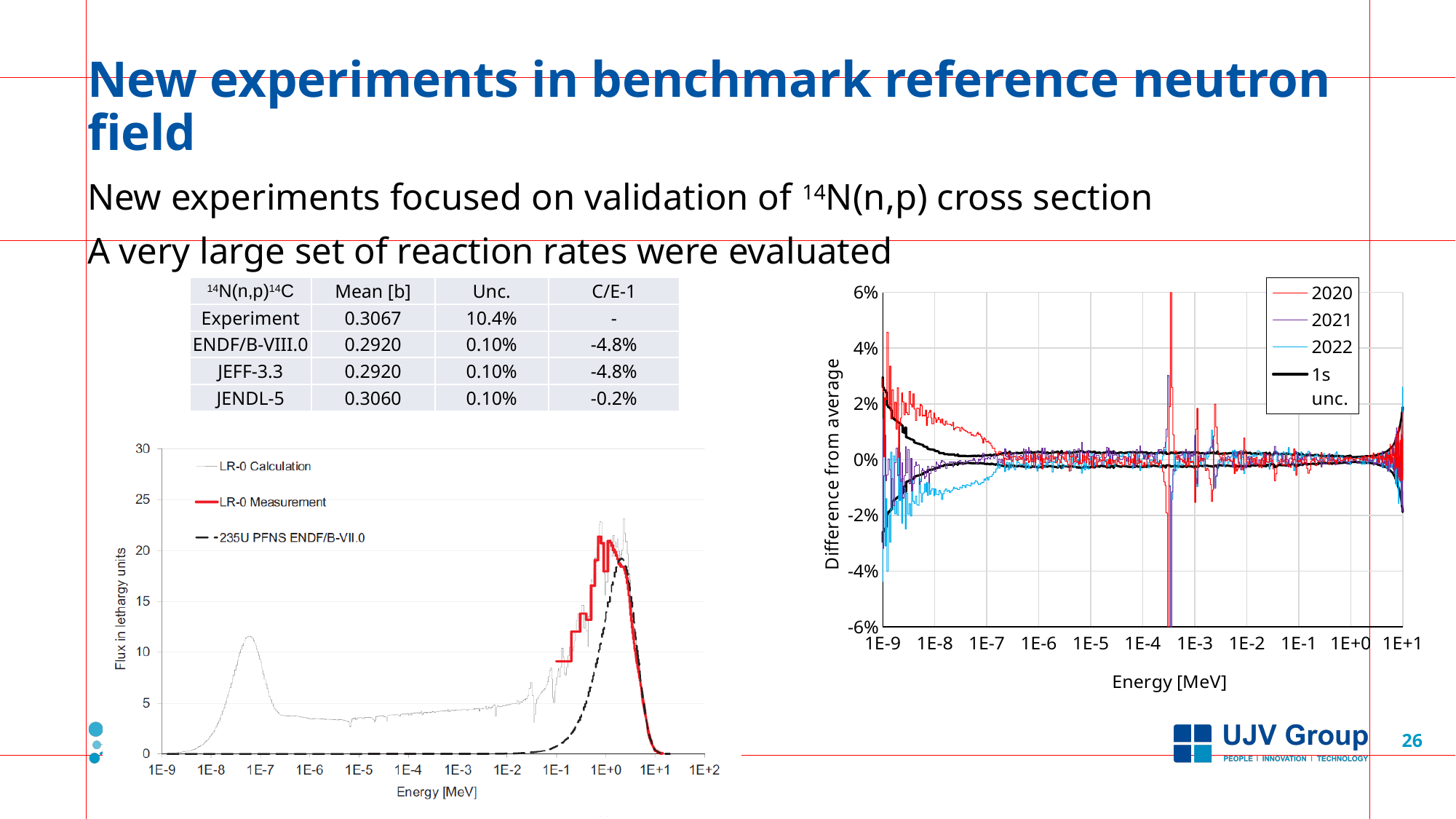
What kind of chart is the left chart showing flux in lethargy units? line chart In the left chart, is the peak of the LR-0 Calculation curve near 1E-7 MeV greater or less than 15? less How many series does the legend of the right chart (difference from average) list? 4 What is the x-axis label of the left chart? Energy [MeV] In the left chart, is the maximum of the LR-0 Measurement curve greater or less than 20? greater In the right chart, does the 2022 series rise or fall as energy increases from 1E-9 to 1E-7 MeV? rise What is the maximum value shown on the y-axis of the right chart? 6% What is the y-axis label of the right chart? Difference from average In the left chart, is the peak of the LR-0 Calculation curve near 1E-7 MeV greater or less than 10? greater In the right chart, does the 2020 series rise or fall as energy increases from 1E-9 to 1E-7 MeV? fall How many series does the legend of the left chart (flux in lethargy units) list? 3